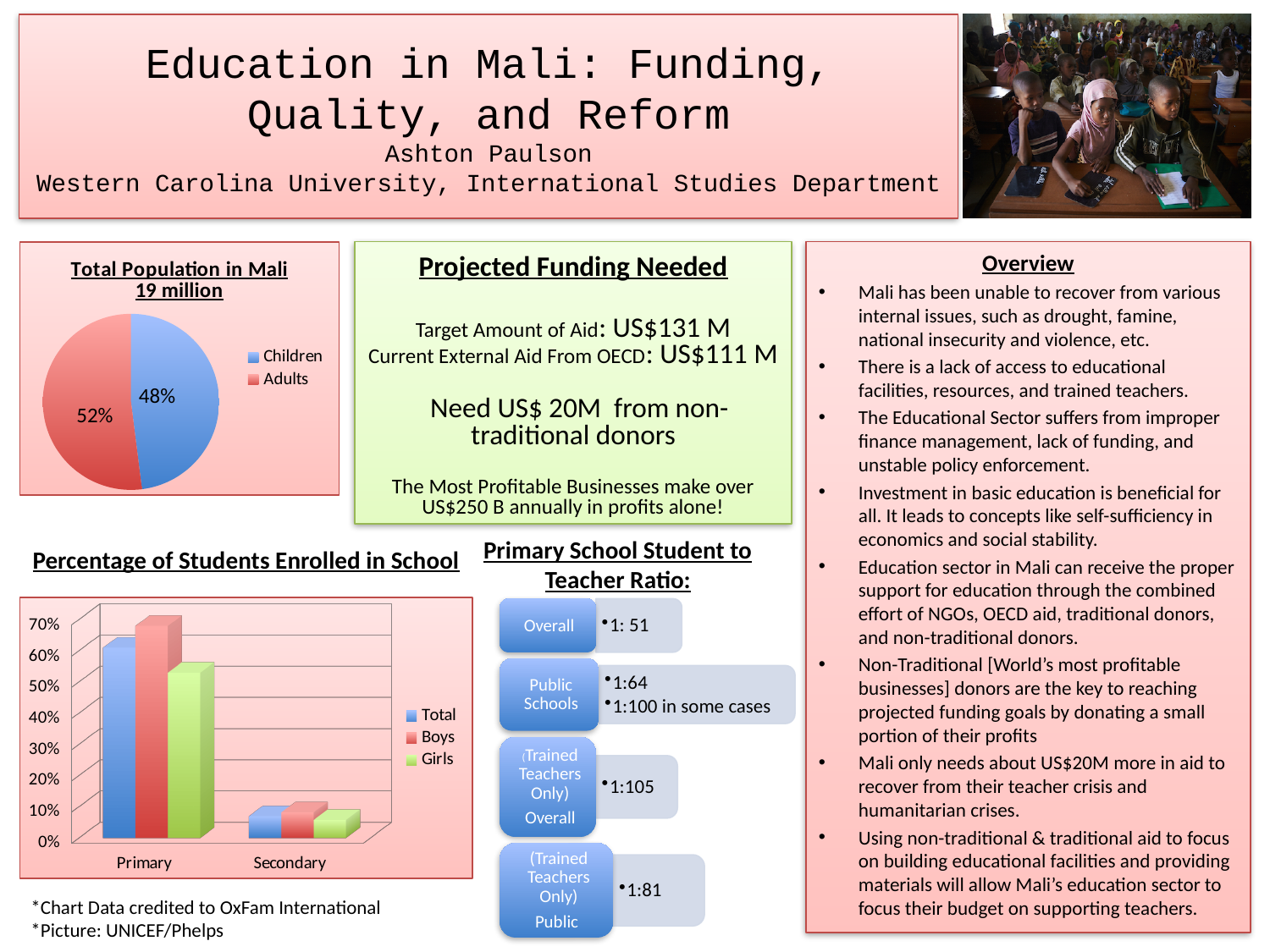
In the 'Percentage of Students Enrolled in School' chart, which category has the larger Total value, Primary or Secondary? Primary In the pie chart titled 'Total Population in Mali 19 million', how many slices are there? 2 In the pie chart titled 'Total Population in Mali 19 million', what percentage is Adults? 52% In the 'Percentage of Students Enrolled in School' chart, how many series does the legend list? 3 In the pie chart titled 'Total Population in Mali 19 million', what percentage is Children? 48% In the 'Percentage of Students Enrolled in School' chart, which series has the highest value for Primary? Boys What kind of chart is the 'Total Population in Mali 19 million' chart? pie chart In the 'Percentage of Students Enrolled in School' chart, is the value for Boys in Primary greater or less than 60%? greater In the pie chart titled 'Total Population in Mali 19 million', which slice is larger, Children or Adults? Adults In the pie chart titled 'Total Population in Mali 19 million', what is the difference in percentage points between Adults and Children? 4% What kind of chart is the 'Percentage of Students Enrolled in School' chart? bar chart In the 'Percentage of Students Enrolled in School' chart, is the value for Total in Secondary greater or less than 20%? less